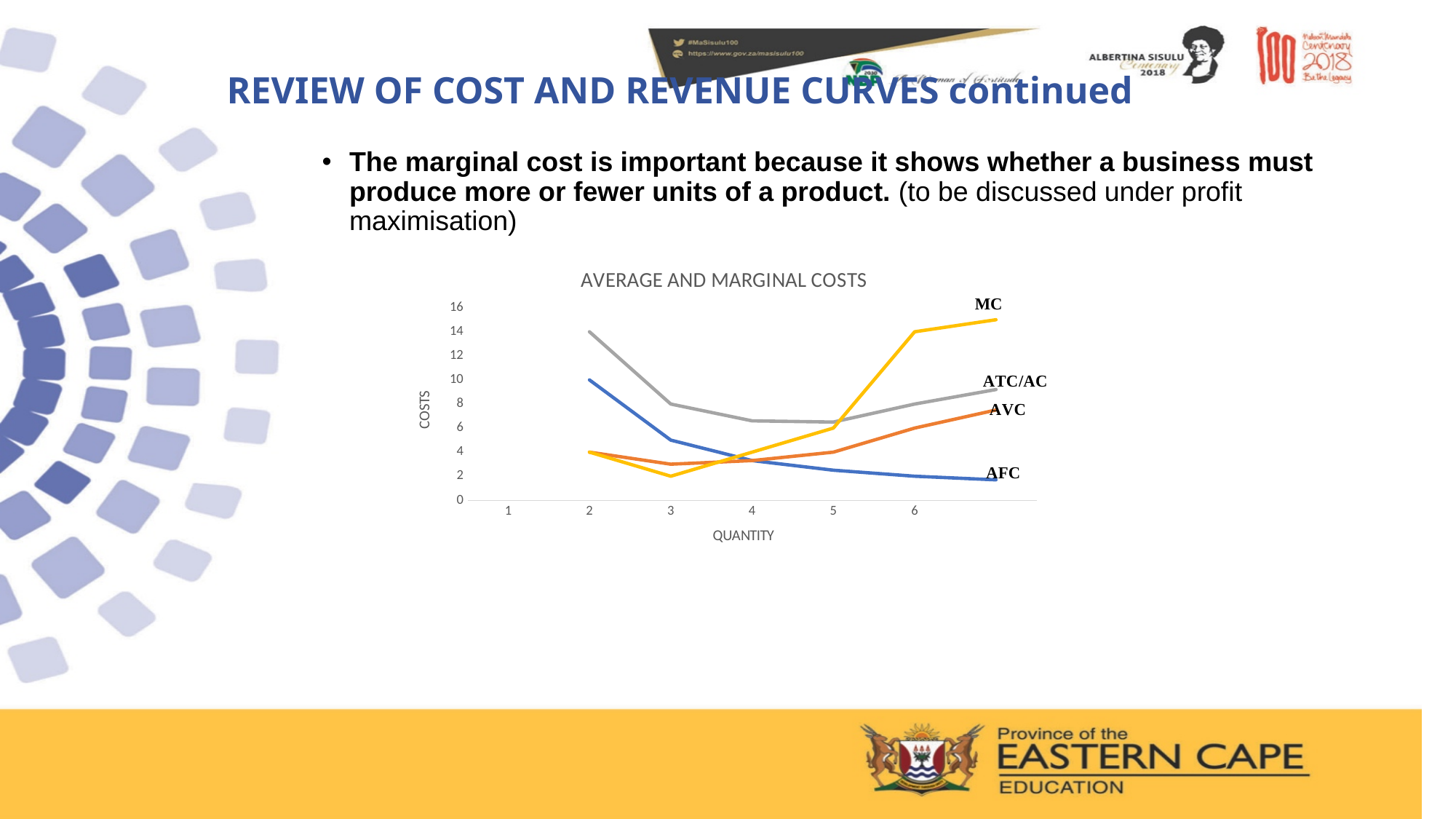
What is the label of the horizontal axis of the chart? QUANTITY Is the value of the AFC curve at quantity 5 greater or less than 4? less Does the MC curve rise or fall between quantity 3 and quantity 6? rise What kind of chart is shown on the slide? line chart At quantity 2, which curve is higher, ATC/AC or AFC? ATC/AC How many cost curves are labelled on the chart? 4 Is the value of the MC curve at quantity 6 greater or less than 12? greater Does the AFC curve rise or fall as quantity increases? fall At quantity 6, which curve is higher, MC or AVC? MC What is the title of the chart? AVERAGE AND MARGINAL COSTS Is the value of the MC curve at quantity 3 greater or less than 4? less